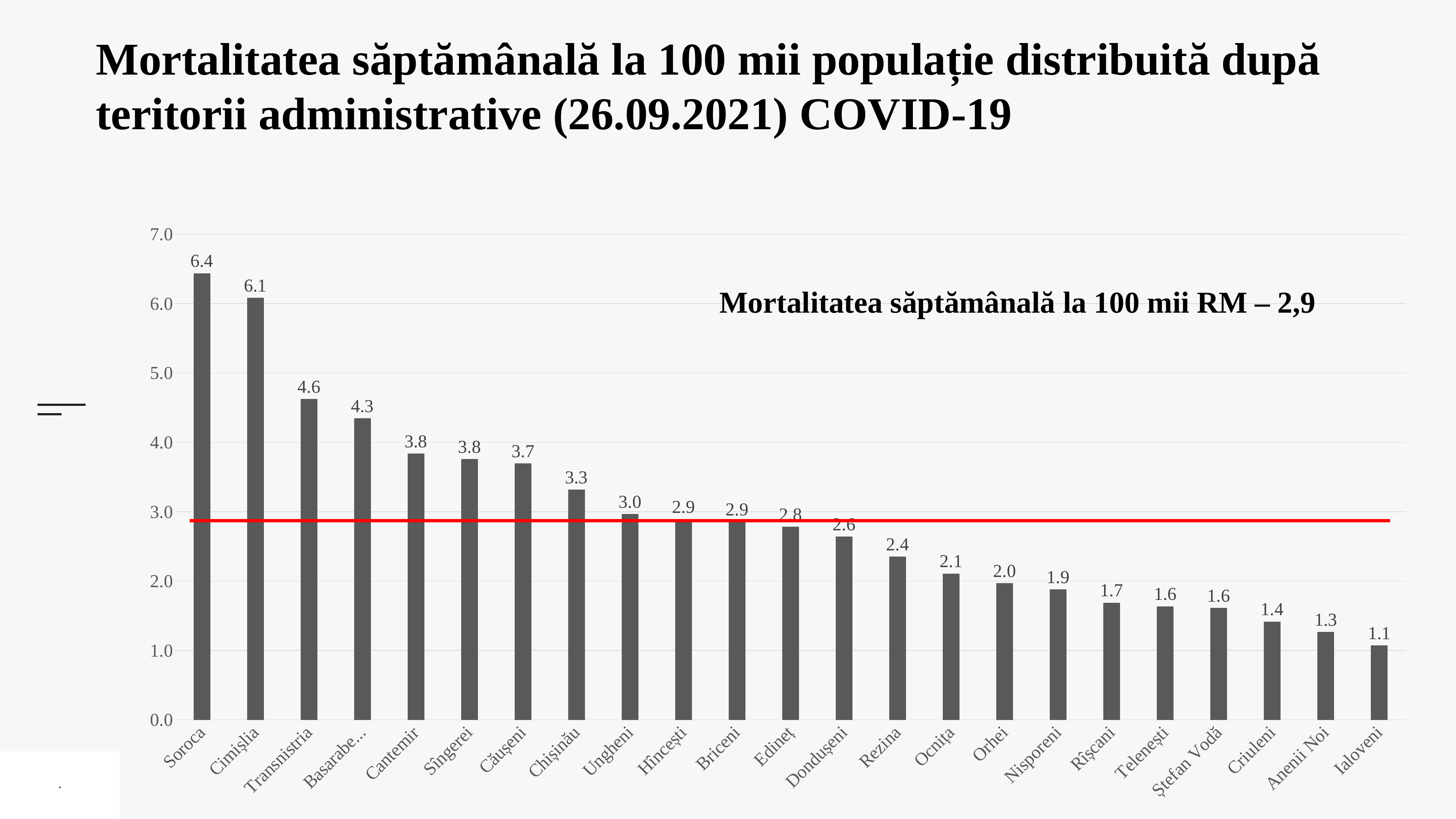
How many territories are shown on the chart? 23 Which has a higher value, Ungheni or Orhei? Ungheni What is the difference between the values for Transnistria and Ialoveni? 3.5 Which territory has the lowest weekly mortality? Ialoveni What national weekly mortality value per 100 thousand for RM is stated on the slide? 2,9 Is the value for Cantemir greater or less than 3.0? greater What is the value shown for Chișinău? 3.3 What type of chart is shown on the slide? bar chart What is the weekly mortality value for Soroca? 6.4 What is the value shown for Rezina? 2.4 Which territory has the highest weekly mortality? Soroca What is the difference between the values for Soroca and Cimișlia? 0.3